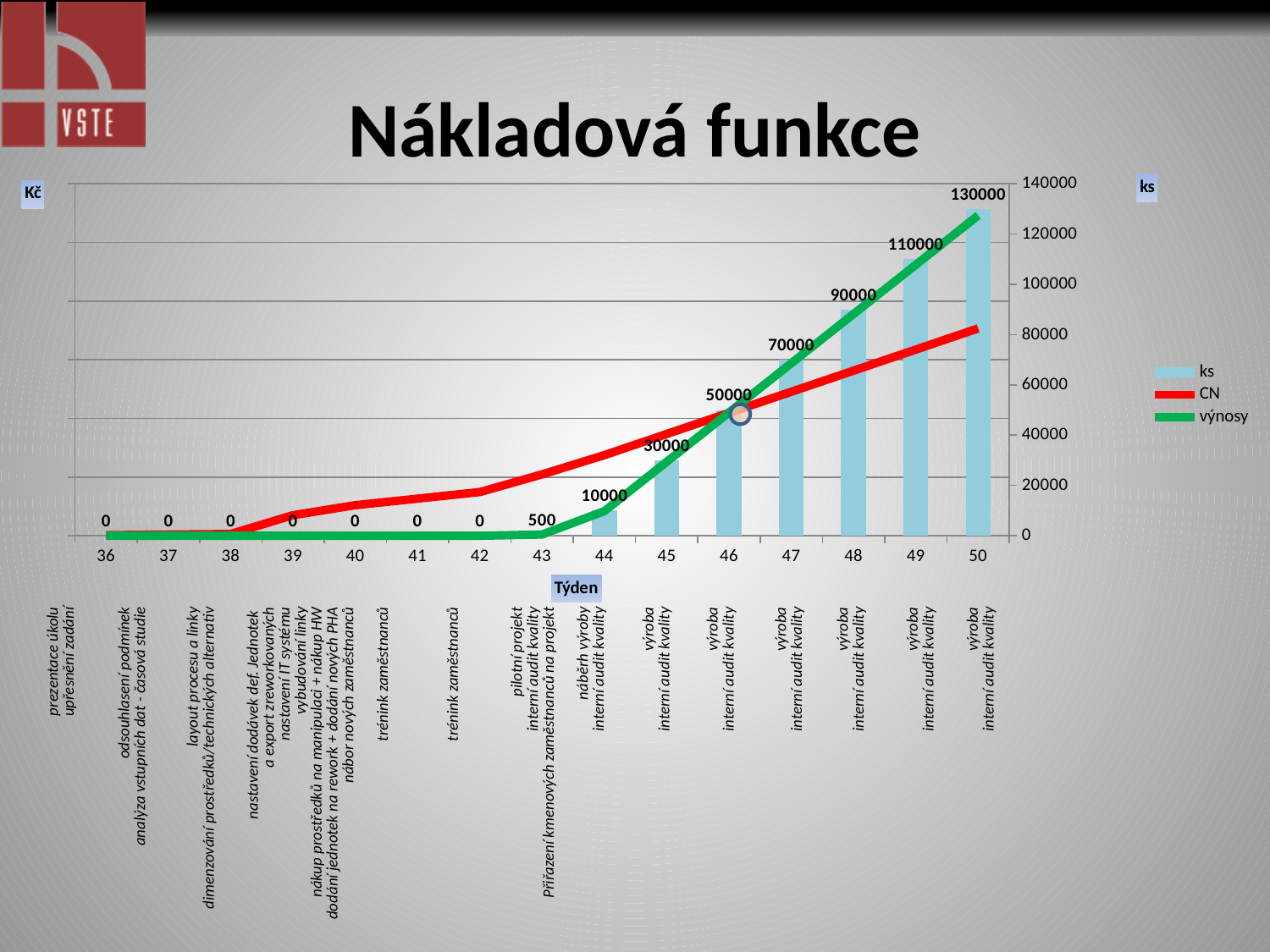
What is the title of the chart? Nákladová funkce Do the ks values rise or fall from week 43 to week 50? rise Which is larger, the ks value for week 45 or for week 47? week 47 How many weeks are shown on the x axis? 15 How many series does the chart legend list? 3 What is the ks value for week 43? 500 Is the výnosy value at week 50 greater or less than 120000? greater Which series is drawn as a red line? CN What is the ks value for week 46? 50000 What is the difference between the ks values for week 50 and week 48? 40000 Which week has the highest ks value? 50